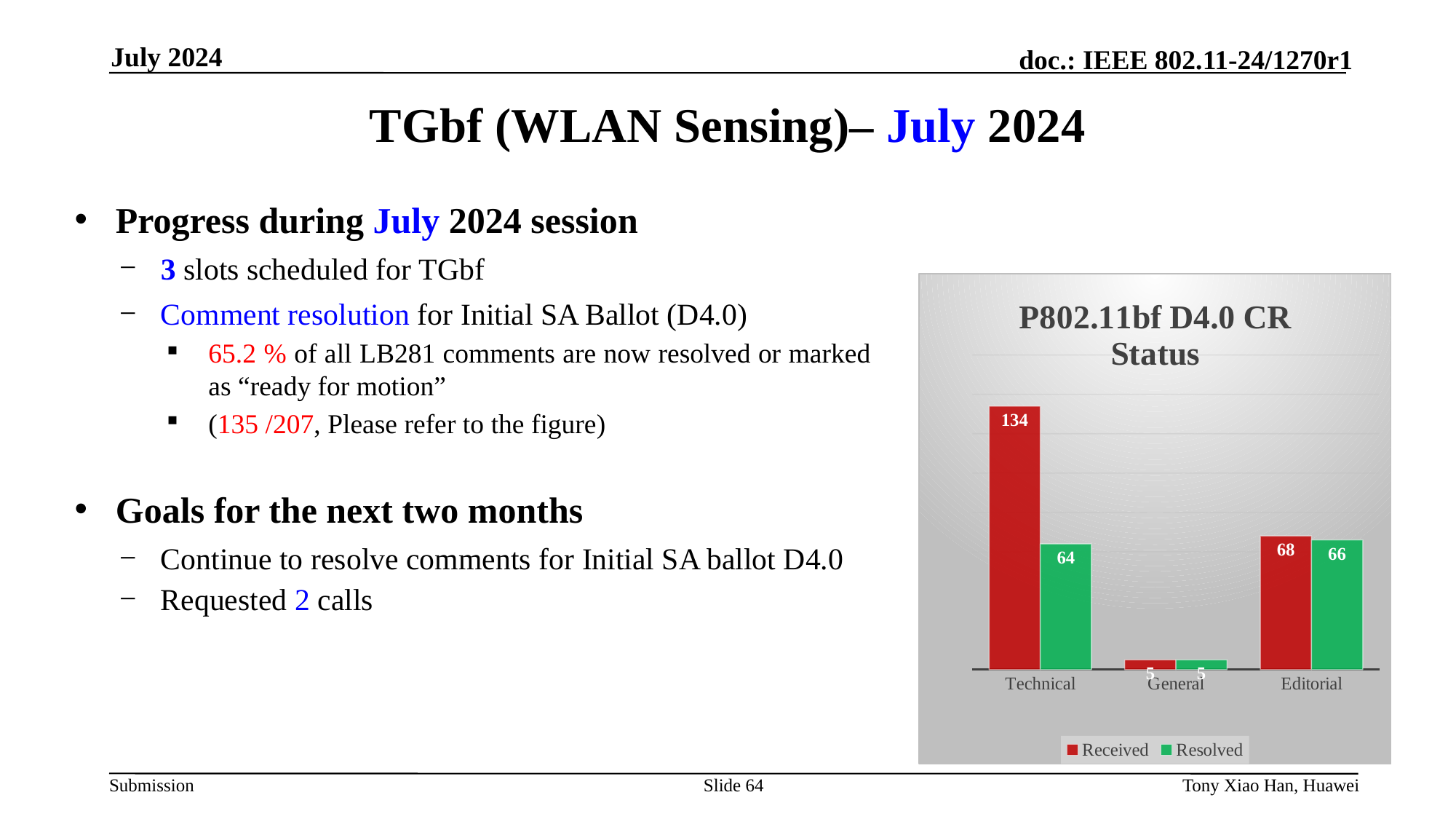
What is the title of the chart? P802.11bf D4.0 CR Status What is the Received value for Editorial? 68 What is the Received value for Technical? 134 How many categories are shown on the x axis? 3 Which category has the highest Received value? Technical How many series does the legend list? 2 What is the Resolved value for General? 5 Which category has the lowest Resolved value? General What is the difference between Received and Resolved for Editorial? 2 What is the difference between Received and Resolved for Technical? 70 Which is larger, the Resolved value for Technical or the Resolved value for Editorial? Editorial What is the Resolved value for Technical? 64